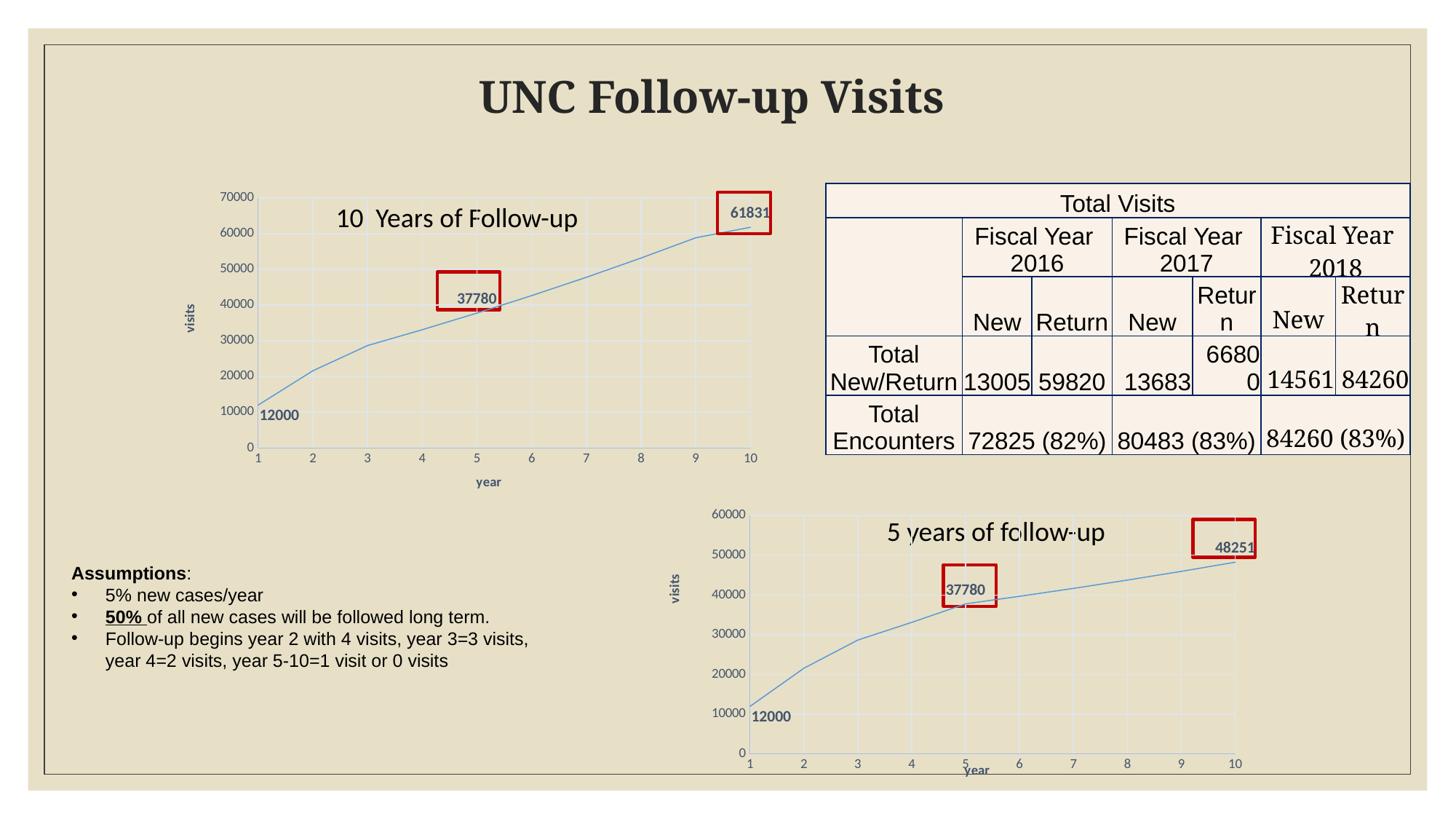
How many years are shown on the x axis of the '5 years of follow-up' chart? 10 In the '10 Years of Follow-up' chart, what is the number of visits at year 10? 61831 In the '5 years of follow-up' chart, what is the difference in visits between year 10 and year 5? 10471 In the '5 years of follow-up' chart, what is the number of visits at year 10? 48251 In the '10 Years of Follow-up' chart, do visits rise or fall as the year increases? rise In the '5 years of follow-up' chart, what is the number of visits at year 5? 37780 What kind of chart is the '10 Years of Follow-up' chart? line chart In the '10 Years of Follow-up' chart, what is the number of visits at year 5? 37780 In the '5 years of follow-up' chart, is the value at year 3 greater or less than 20000? greater In the '10 Years of Follow-up' chart, what is the number of visits at year 1? 12000 Which chart shows a higher value at year 10, '10 Years of Follow-up' or '5 years of follow-up'? 10 Years of Follow-up In the '10 Years of Follow-up' chart, what is the difference in visits between year 10 and year 1? 49831